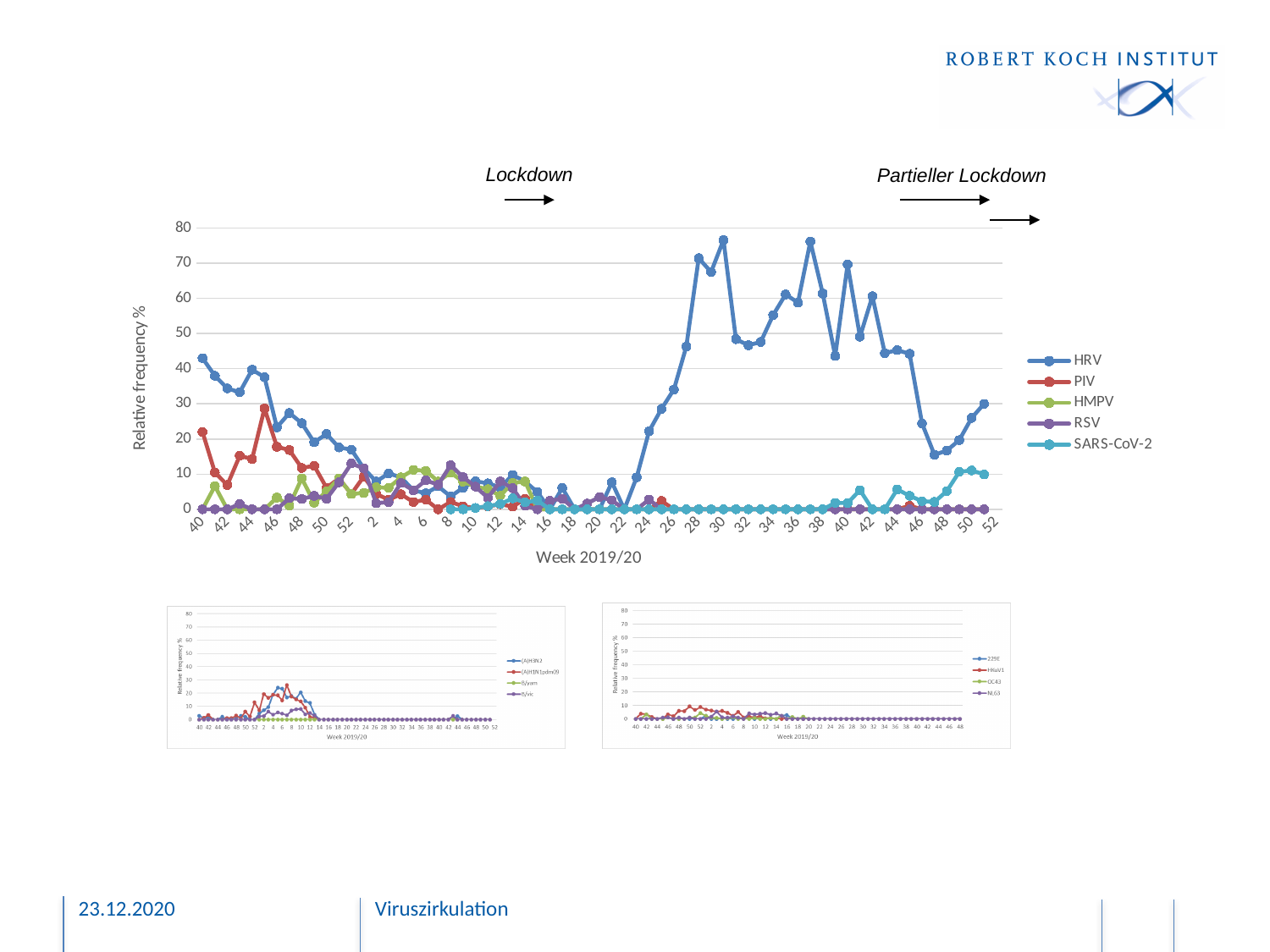
How many series does the legend of the bottom-left chart list? 4 What is the y-axis title of the large chart? Relative frequency % In the large chart, which is larger at week 50 of 2020, HRV or SARS-CoV-2? HRV In the large chart, does the HRV series rise or fall between week 22 and week 30 of 2020? rise Which series are listed in the legend of the large chart? HRV, PIV, HMPV, RSV, SARS-CoV-2 In the large chart, is the value for SARS-CoV-2 at week 50 of 2020 greater or less than 20? less In the large chart, is the value for HRV at the first week (week 40 of 2019) greater or less than 30? greater In the large chart, is the peak value of PIV around week 45 of 2019 greater or less than 20? greater What kind of chart is the large chart on the slide? line chart How many series does the legend of the large chart list? 5 In the large chart, which series reaches the highest value? HRV